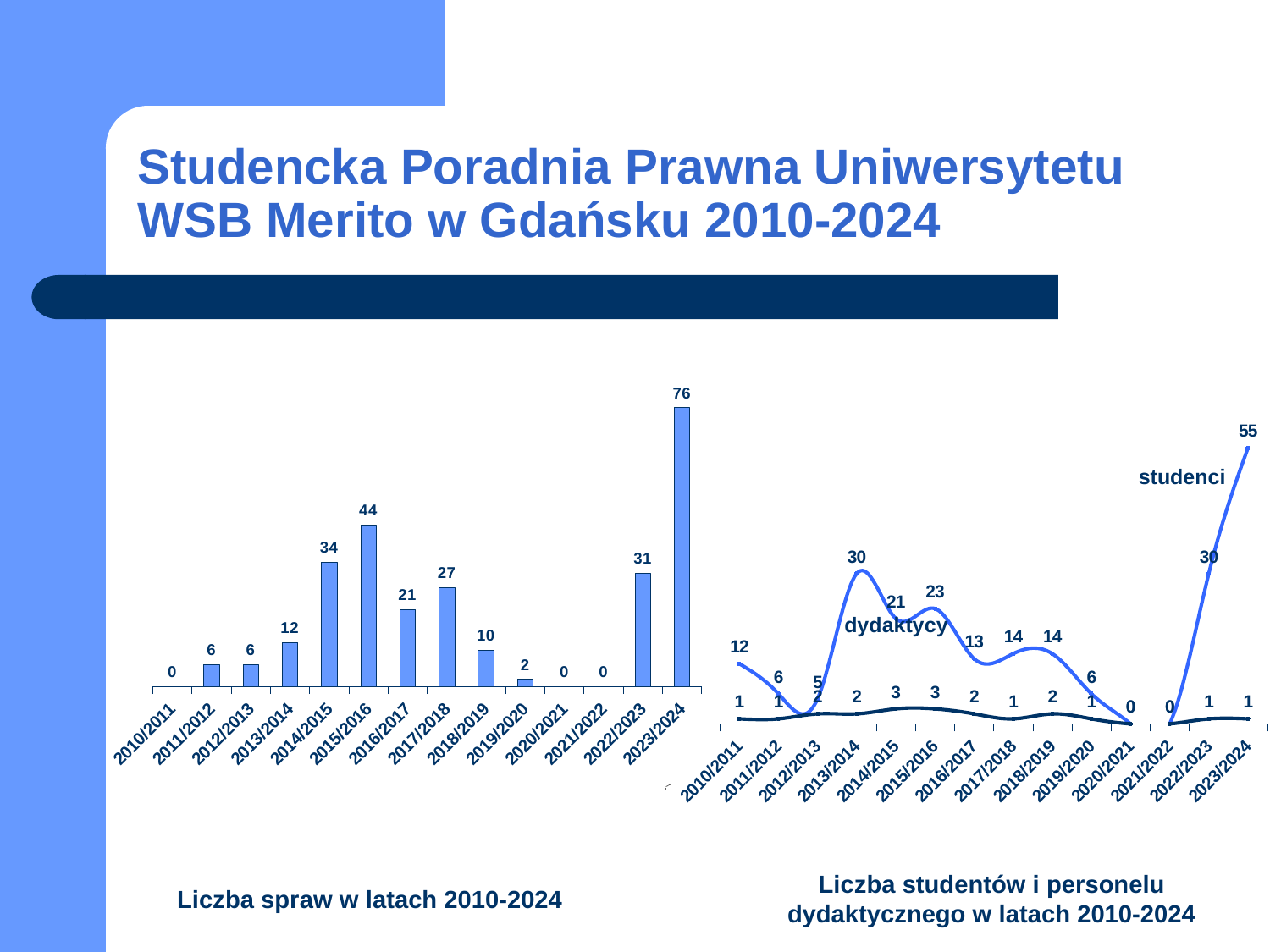
In the chart 'Liczba spraw w latach 2010-2024', what is the difference between the values for 2023/2024 and 2022/2023? 45 In the chart 'Liczba spraw w latach 2010-2024', how many years are shown on the x axis? 14 In the chart 'Liczba studentów i personelu dydaktycznego w latach 2010-2024', what is the value of the 'dydaktycy' series for 2014/2015? 3 In the chart 'Liczba studentów i personelu dydaktycznego w latach 2010-2024', what is the value of the 'studenci' series for 2023/2024? 55 What kind of chart is 'Liczba spraw w latach 2010-2024'? bar chart In the chart 'Liczba studentów i personelu dydaktycznego w latach 2010-2024', what is the value of the 'studenci' series for 2013/2014? 30 In the chart 'Liczba spraw w latach 2010-2024', which is larger, the value for 2014/2015 or the value for 2017/2018? 2014/2015 What kind of chart is 'Liczba studentów i personelu dydaktycznego w latach 2010-2024'? line chart In the chart 'Liczba spraw w latach 2010-2024', what is the value for 2015/2016? 44 In the chart 'Liczba spraw w latach 2010-2024', which year has the highest value? 2023/2024 In the chart 'Liczba spraw w latach 2010-2024', what is the value for 2023/2024? 76 In the chart 'Liczba studentów i personelu dydaktycznego w latach 2010-2024', how many series are plotted? 2